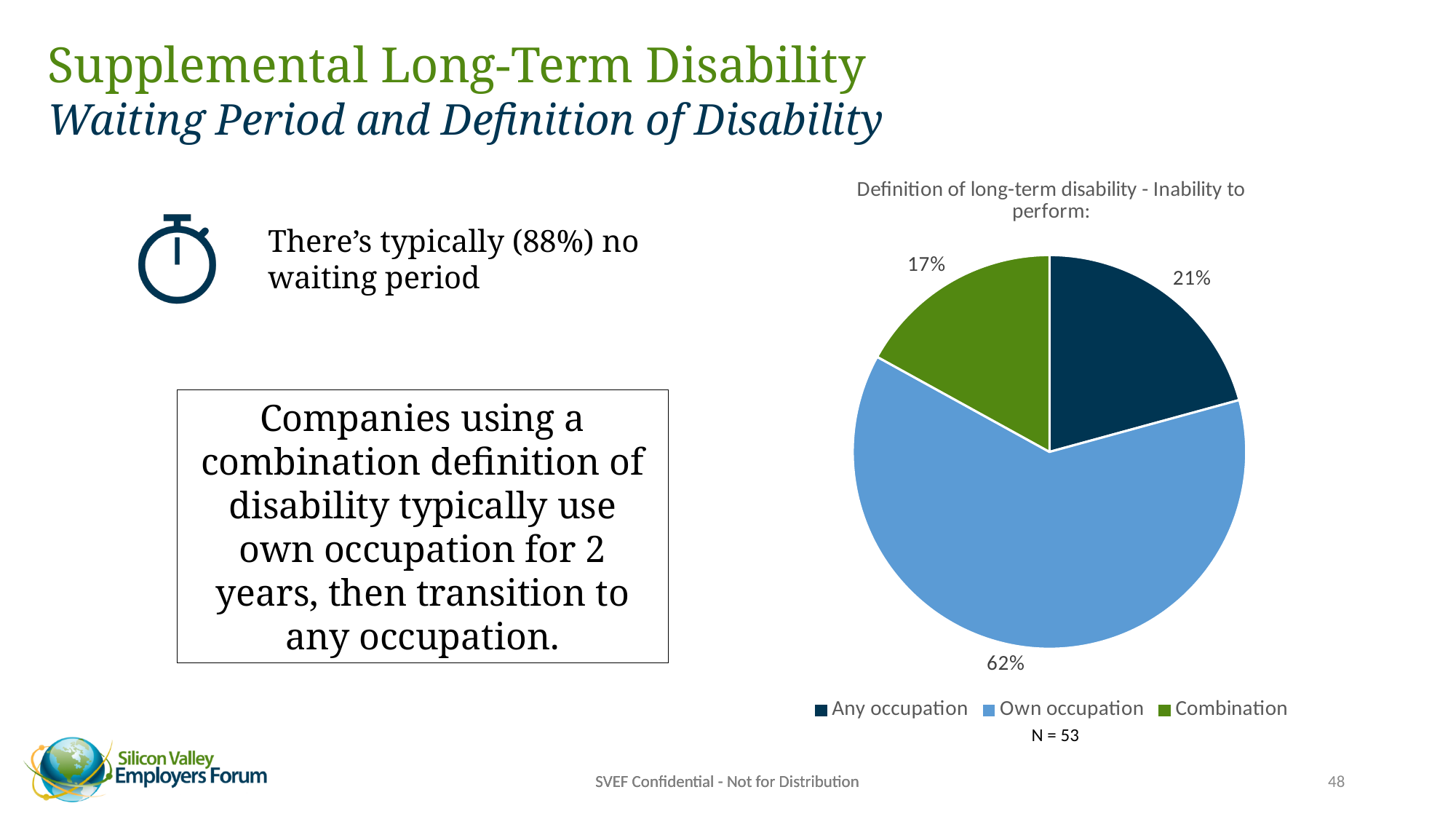
Which category has the largest share of the pie? Own occupation What is the title of the pie chart? Definition of long-term disability - Inability to perform: What colour is the Combination slice in the pie chart? Green What is the difference in percentage points between Own occupation and Any occupation? 41 What is the difference in percentage points between Any occupation and Combination? 4 What kind of chart is shown on the slide? Pie chart What percentage of the pie is Any occupation? 21% Which is larger, the share for Any occupation or the share for Combination? Any occupation Which category has the smallest share of the pie? Combination How many slices does the pie chart have? 3 What percentage of the pie is Own occupation? 62% What percentage of the pie is Combination? 17%